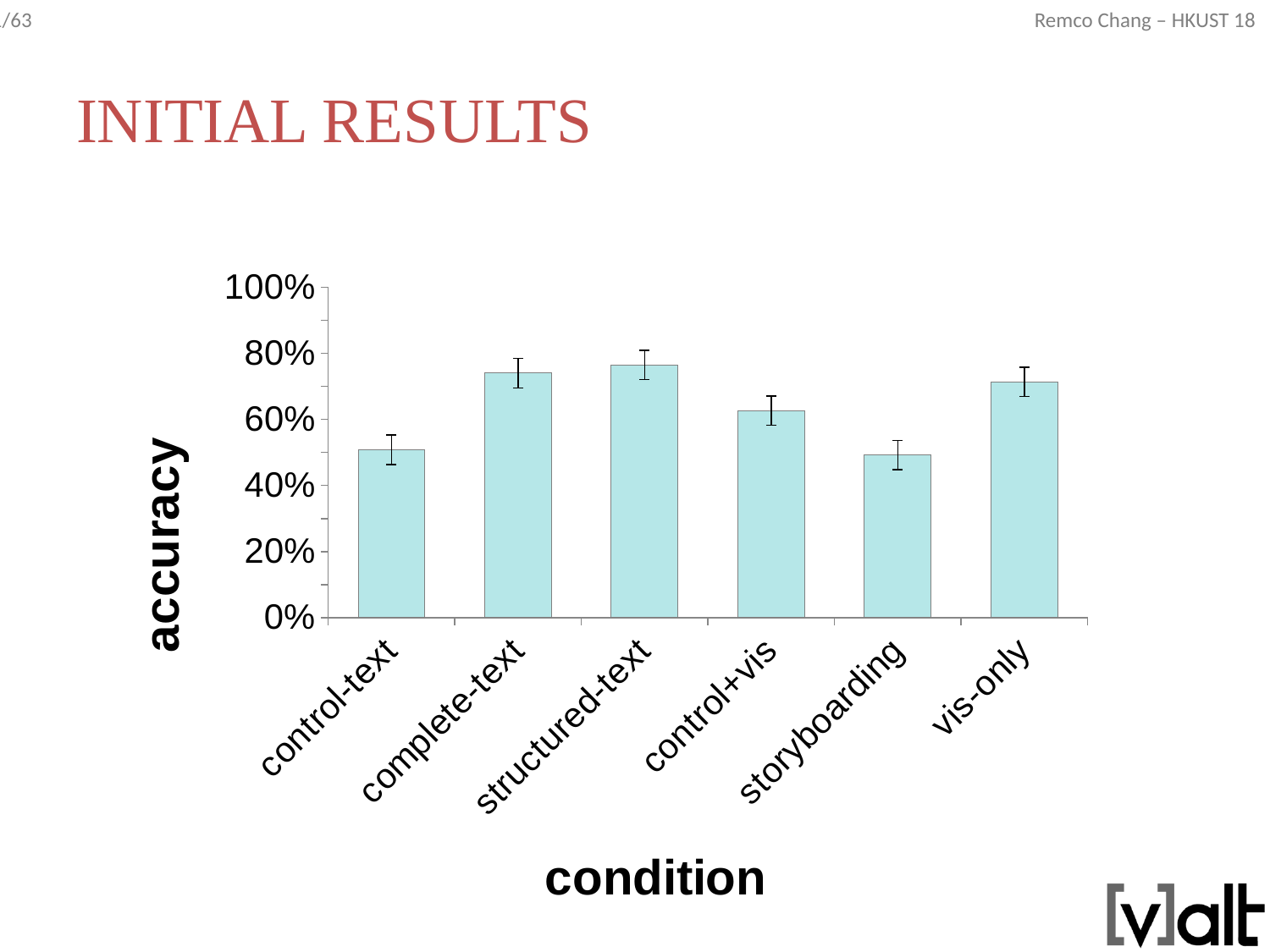
Which condition has the higher accuracy, complete-text or control-text? complete-text Which condition has the higher accuracy, structured-text or storyboarding? structured-text Is the accuracy for vis-only greater or less than 60%? greater What is the label of the y axis of the chart? accuracy How many conditions are plotted on the x axis of the chart? 6 Which condition has the higher accuracy, vis-only or control+vis? vis-only Is the accuracy for structured-text greater or less than 80%? less Is the accuracy for storyboarding greater or less than 60%? less What is the label of the x axis of the chart? condition What kind of chart is shown on the slide? bar chart